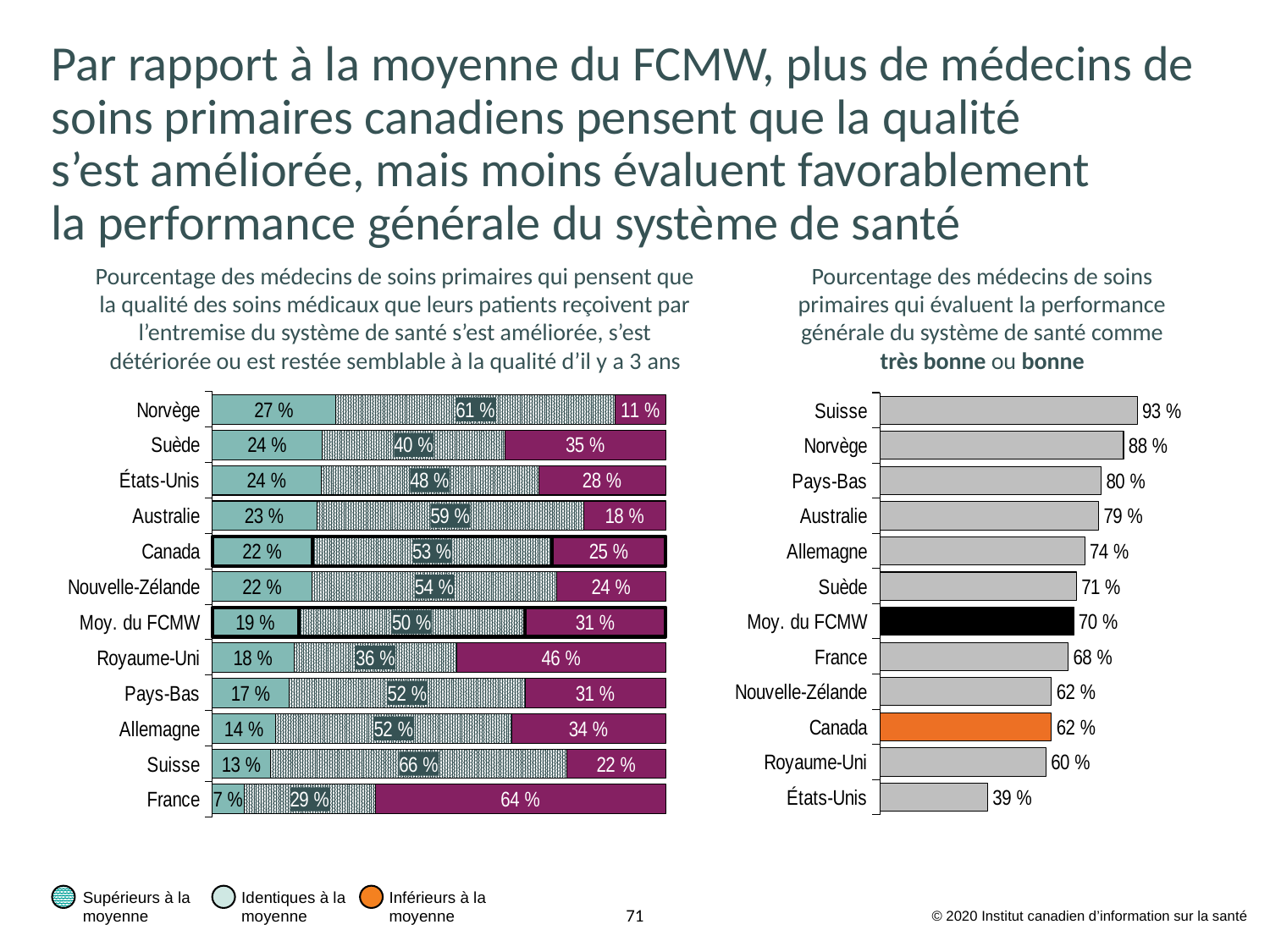
On the left chart (qualité des soins améliorée, détériorée ou semblable), what is the value of the rightmost segment for France? 64 % On the right chart (performance générale du système de santé), which category has the highest value? Suisse On the right chart (performance générale du système de santé), what is the value for Moy. du FCMW? 70 % On the right chart (performance générale du système de santé), what is the value for Canada? 62 % On the right chart (performance générale du système de santé), what is the difference between the values for Suisse and États-Unis? 54 % On the left chart (qualité des soins améliorée, détériorée ou semblable), which category has the largest rightmost segment? France On the right chart (performance générale du système de santé), which category's bar is coloured orange? Canada On the right chart (performance générale du système de santé), how many categories are plotted? 12 On the left chart (qualité des soins améliorée, détériorée ou semblable), is the leftmost segment larger for Canada or for Moy. du FCMW? Canada On the left chart (qualité des soins améliorée, détériorée ou semblable), what is the value of the leftmost segment for Norvège? 27 % What kind of chart is the right chart (performance générale du système de santé)? Bar chart On the right chart (performance générale du système de santé), which category has the lowest value? États-Unis